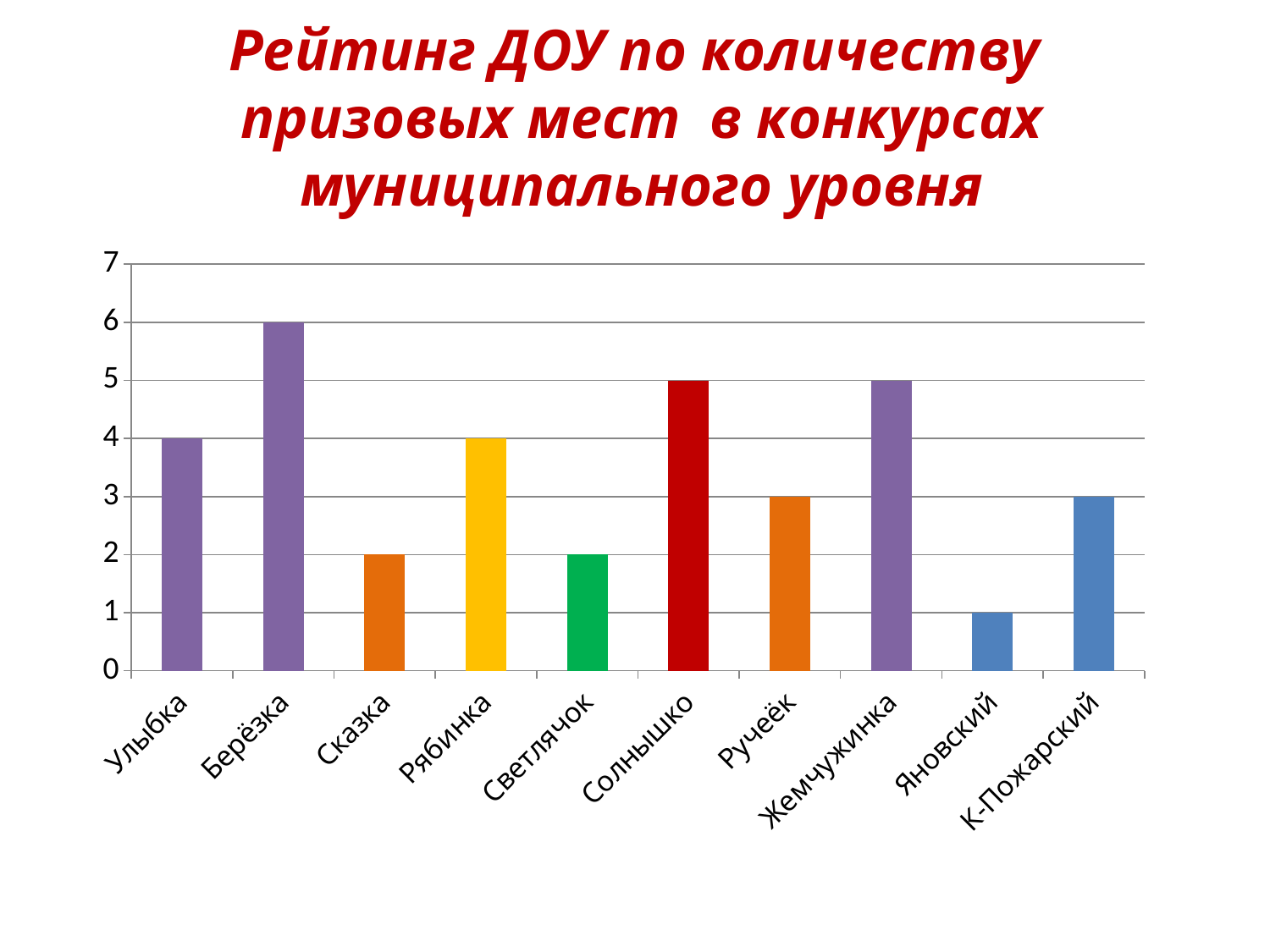
What is the title of the chart? Рейтинг ДОУ по количеству призовых мест в конкурсах муниципального уровня Which category has the lowest value? Яновский Which is larger, the value for Улыбка or the value for Светлячок? Улыбка What is the value for Яновский? 1 Which category has the highest value? Берёзка Is the value for Жемчужинка greater or less than 3? greater What is the difference between the values for Берёзка and Сказка? 4 How many categories are shown on the x axis? 10 What is the value for Берёзка? 6 What is the value for Солнышко? 5 What is the value for Ручеёк? 3 What kind of chart is shown on the slide? bar chart